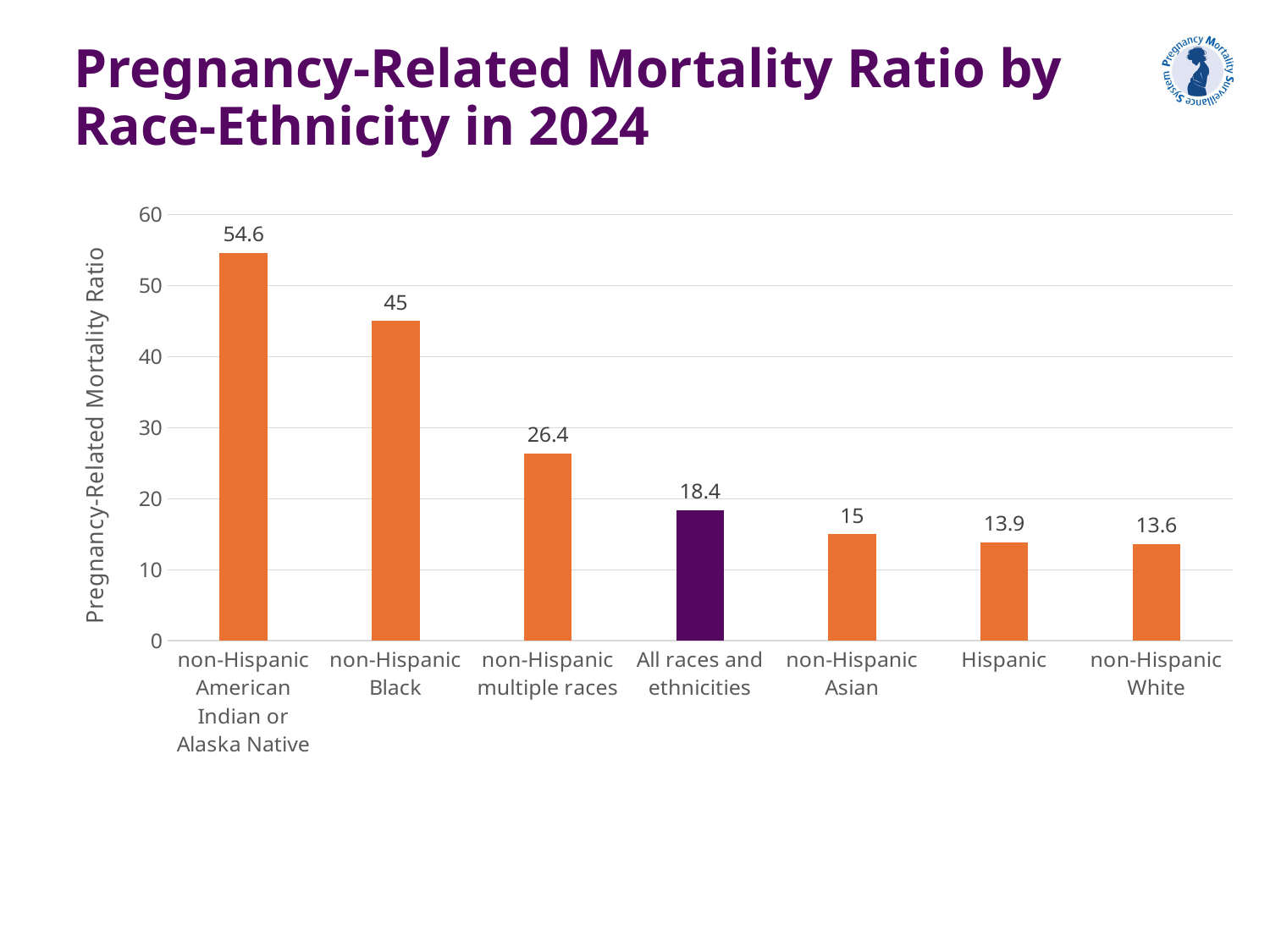
How many race-ethnicity categories are shown on the chart? 7 What is the pregnancy-related mortality ratio for non-Hispanic Black? 45 Which has a higher pregnancy-related mortality ratio, non-Hispanic Asian or Hispanic? non-Hispanic Asian What kind of chart is shown on the slide? Bar chart Is the value for non-Hispanic multiple races greater or less than 30? less What is the difference between the pregnancy-related mortality ratio for non-Hispanic multiple races and All races and ethnicities? 8 Which bar is shown in a different colour (purple) from the others? All races and ethnicities What is the pregnancy-related mortality ratio for All races and ethnicities? 18.4 Which race-ethnicity category has the highest pregnancy-related mortality ratio? non-Hispanic American Indian or Alaska Native What is the pregnancy-related mortality ratio for non-Hispanic White? 13.6 What is the difference between the pregnancy-related mortality ratio for non-Hispanic American Indian or Alaska Native and non-Hispanic Black? 9.6 Which race-ethnicity category has the lowest pregnancy-related mortality ratio? non-Hispanic White